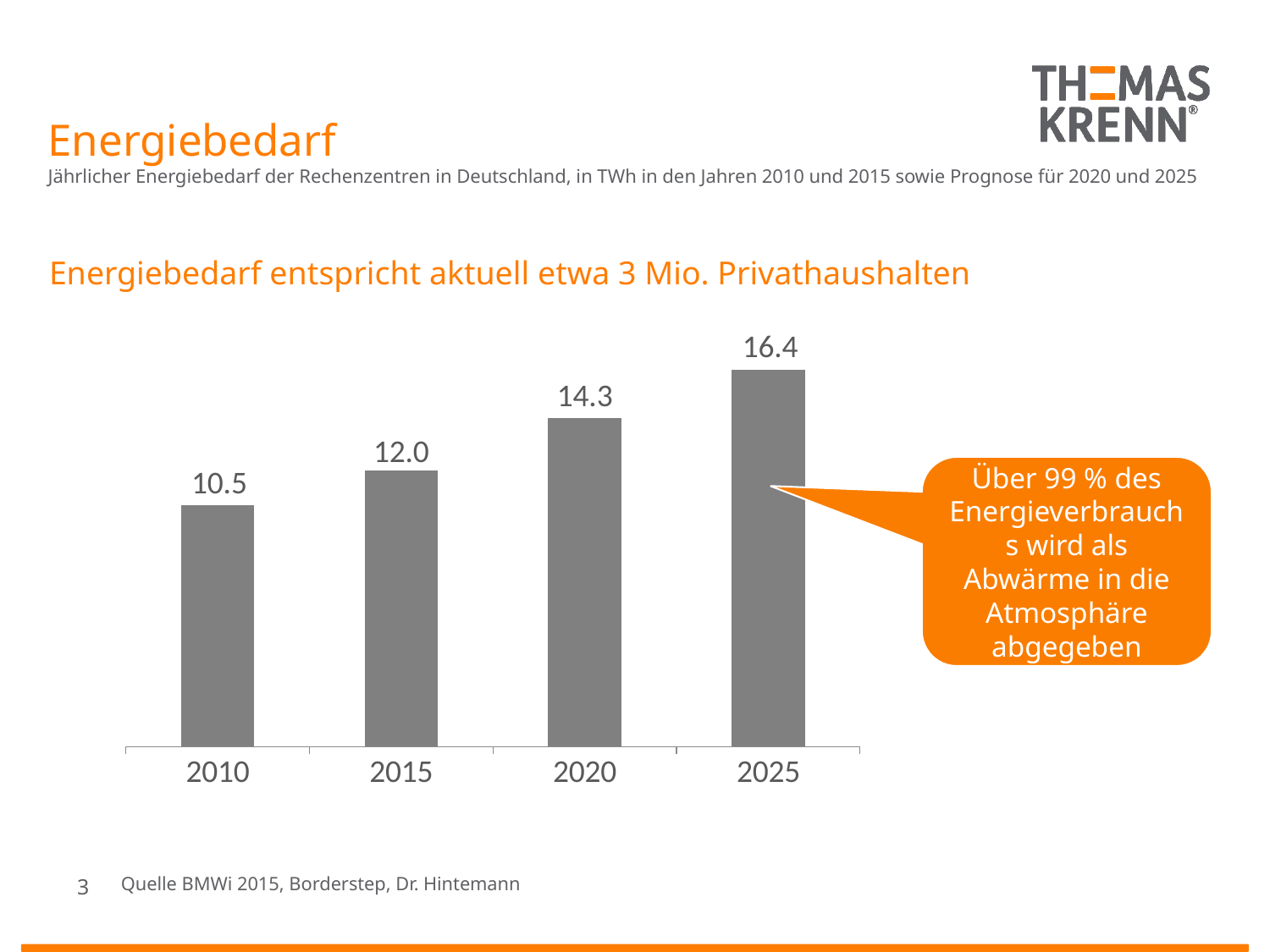
What is the value shown for 2025? 16.4 What is the difference between the values for 2020 and 2015? 2.3 What is the value shown for 2010? 10.5 Which year has the highest value? 2025 Do the values rise or fall from 2010 to 2025? Rise What is the value shown for 2020? 14.3 How many bars are shown in the chart? 4 What is the difference between the values for 2025 and 2010? 5.9 What kind of chart is shown on the slide? Bar chart What is the value shown for 2015? 12.0 Which year has the lowest value? 2010 Which is larger, the value for 2015 or the value for 2020? 2020